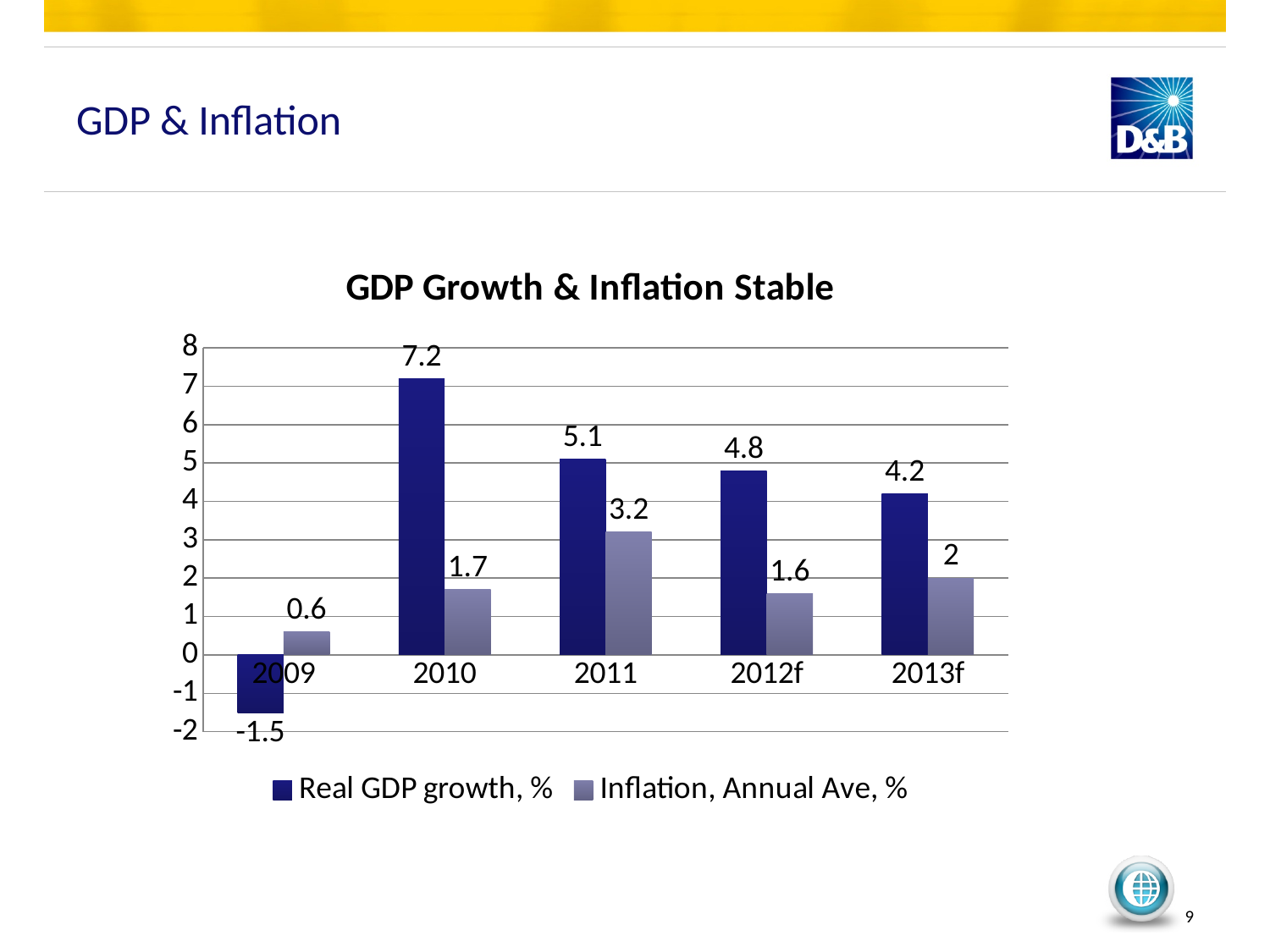
What is the Inflation, Annual Ave, % value for 2013f? 2 What kind of chart is shown? Bar chart Which year has the highest Real GDP growth, %? 2010 How many series does the legend list? 2 What is the Inflation, Annual Ave, % value for 2011? 3.2 What is the title of the chart? GDP Growth & Inflation Stable Which year has the lowest Inflation, Annual Ave, %? 2009 What is the Real GDP growth, % value for 2010? 7.2 What is the difference between Real GDP growth, % in 2010 and 2011? 2.1 How many years are shown on the x axis? 5 What is the Real GDP growth, % value for 2009? -1.5 Which is larger: Inflation, Annual Ave, % in 2012f or in 2013f? 2013f